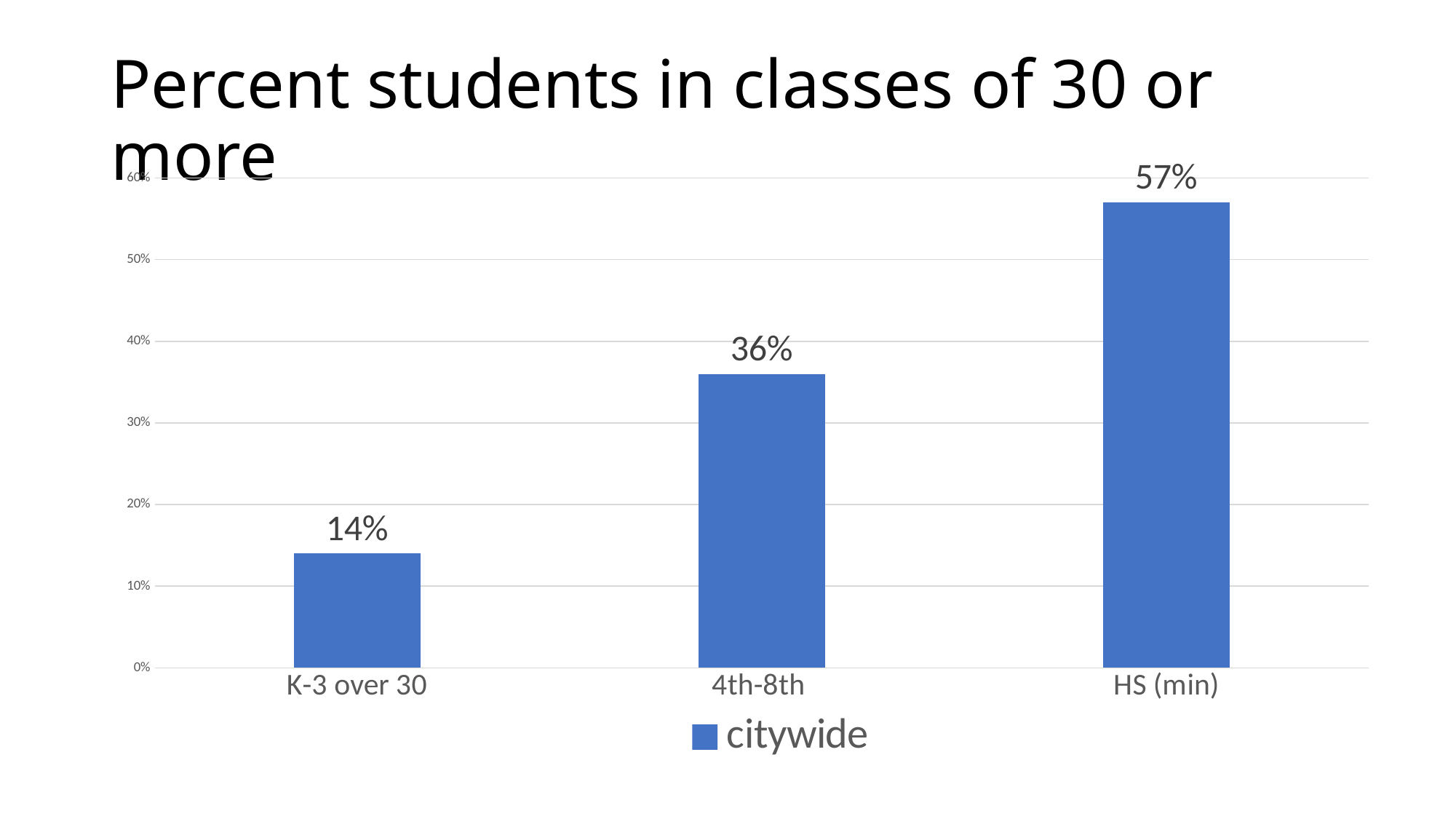
What is the value for 4th-8th? 36% What is the value for K-3 over 30? 14% Which is larger, the value for 4th-8th or the value for K-3 over 30? 4th-8th How many categories are shown on the x axis? 3 What is the value for HS (min)? 57% Which category has the lowest value? K-3 over 30 What is the difference between the values for 4th-8th and K-3 over 30? 22% Which category has the highest value? HS (min) Is the value for HS (min) greater or less than 50%? greater What kind of chart is shown on the slide? bar chart What is the difference between the values for HS (min) and 4th-8th? 21% What series name does the legend list? citywide